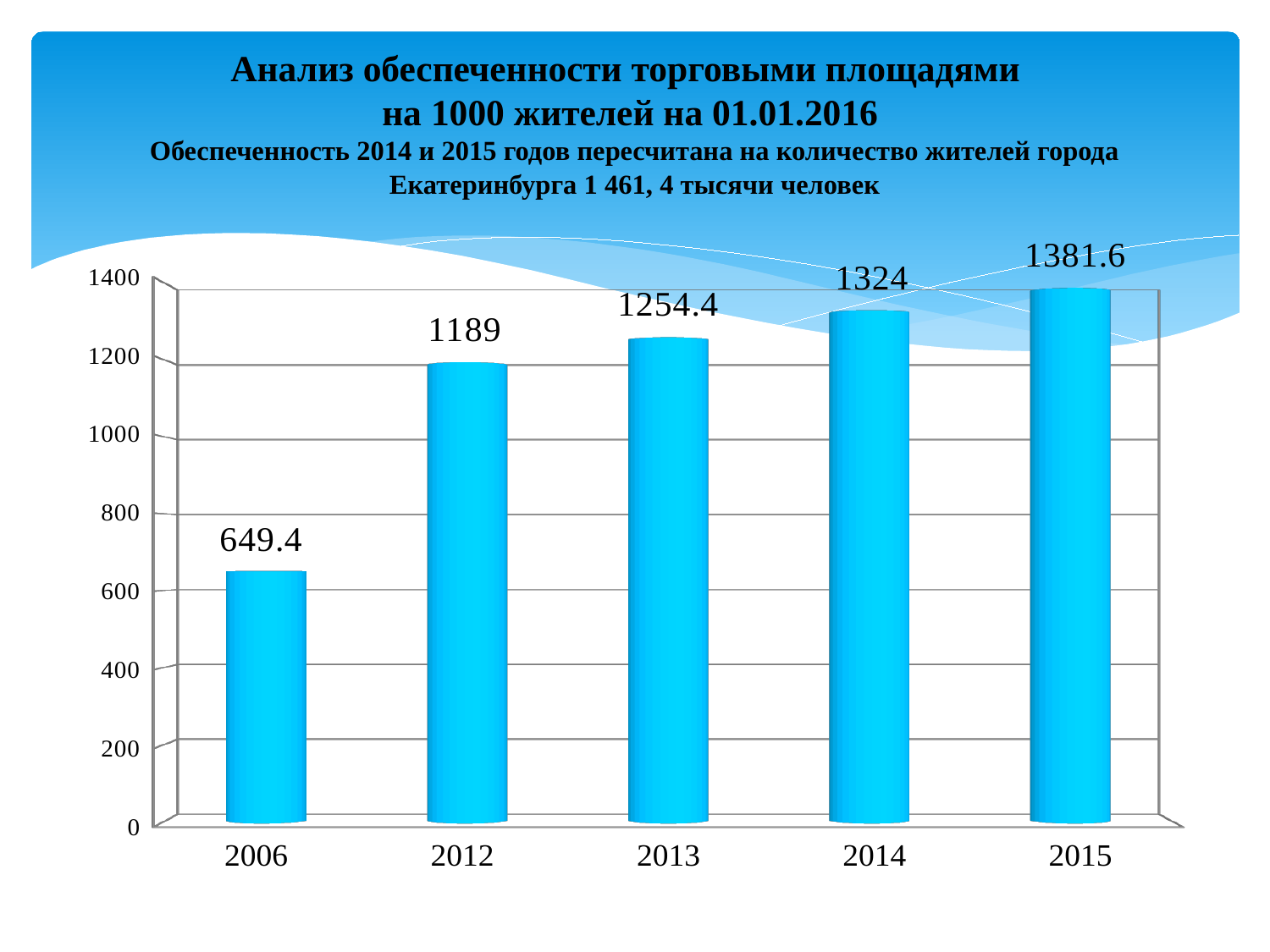
Which is larger, the value for 2012 or the value for 2013? 2013 What is the value for 2015? 1381.6 What is the value for 2013? 1254.4 What kind of chart is shown on the slide? bar chart What is the difference between the values for 2015 and 2014? 57.6 Do the values rise or fall from 2006 to 2015? rise How many years are shown on the x axis? 5 Which year has the highest value? 2015 Which year has the lowest value? 2006 What is the value for 2014? 1324 What is the value for 2012? 1189 What is the value for 2006? 649.4